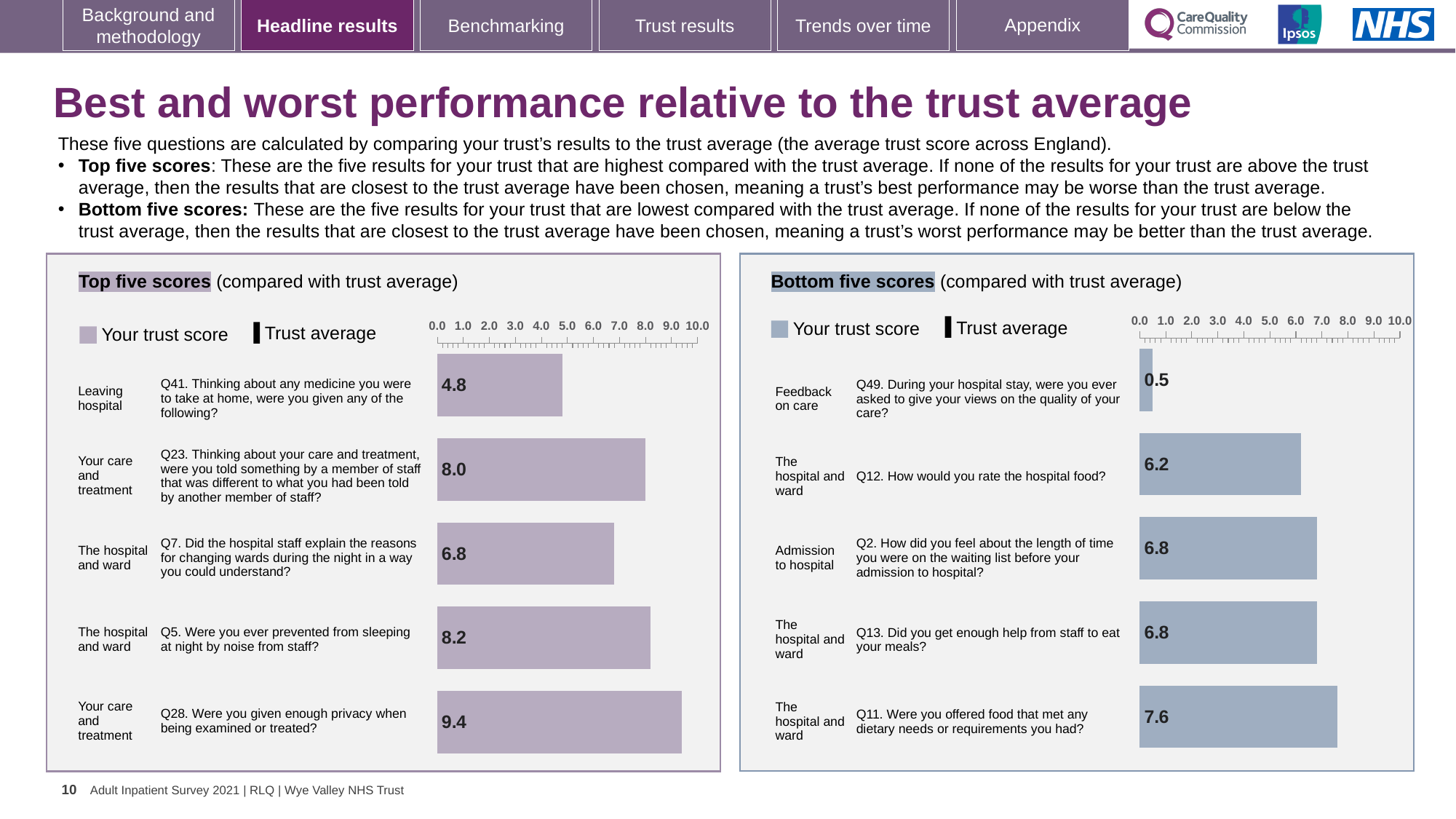
In the Top five scores chart, what is the trust score for Q28 (privacy when being examined or treated)? 9.4 In the Bottom five scores chart, what is the trust score for Q49 (asked to give your views on the quality of your care)? 0.5 In the Bottom five scores chart, what is the difference between the scores for Q11 and Q12? 1.4 In the Bottom five scores chart, which question has the lowest trust score? Q49 How many questions are plotted in the Bottom five scores chart? 5 What kind of chart is the Top five scores chart? Bar chart In the Top five scores chart, what is the difference between the scores for Q5 and Q41? 3.4 In the Top five scores chart, what is the trust score for Q41 (medicine to take at home)? 4.8 In the Top five scores chart, which question has the highest trust score? Q28 How many series does the legend of the Bottom five scores chart list? 2 In the Top five scores chart, which has the larger score: Q23 or Q7? Q23 In the Bottom five scores chart, what is the trust score for Q12 (how would you rate the hospital food)? 6.2